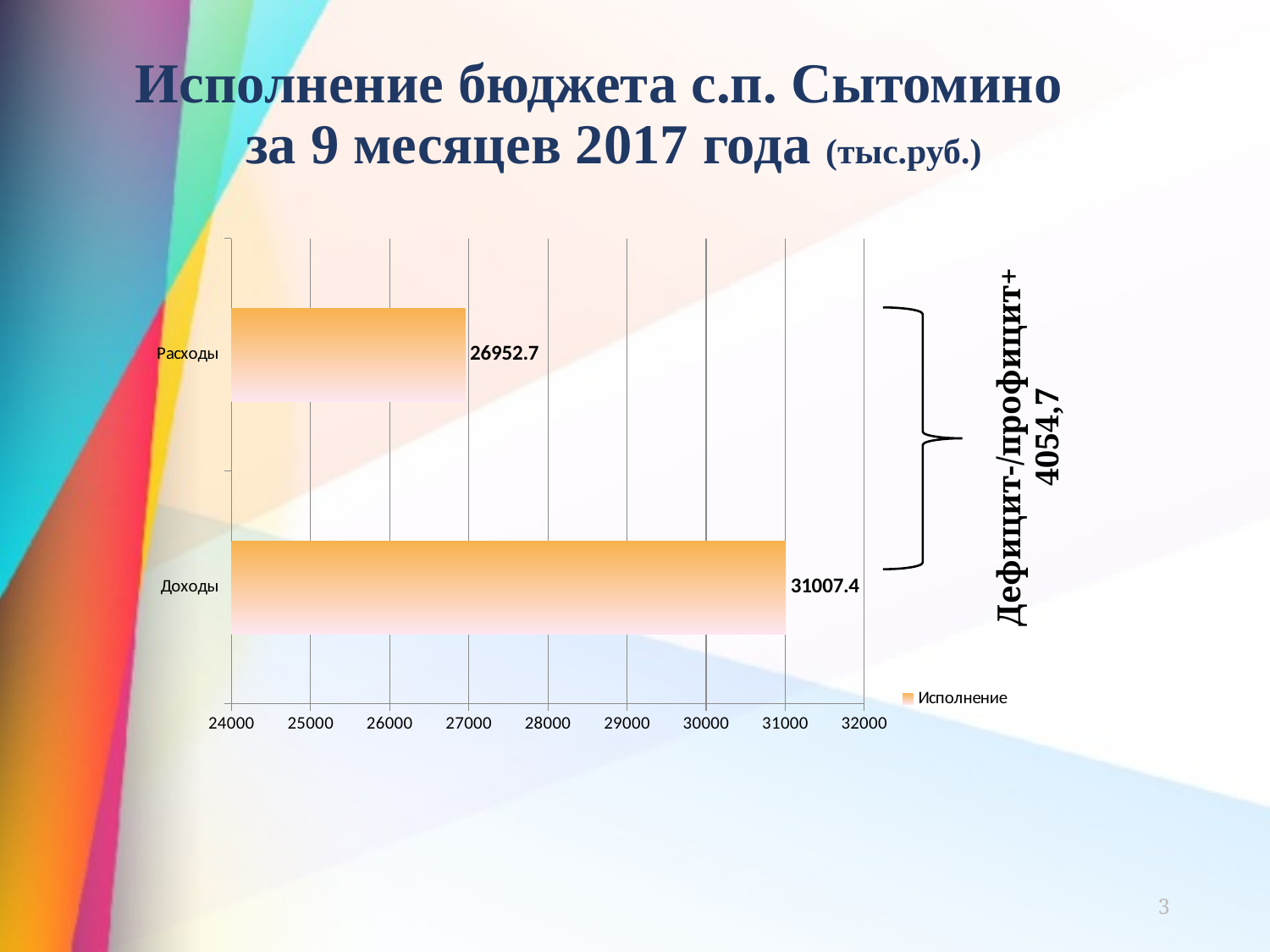
Which category has the highest value? Доходы What is the name of the series shown in the legend? Исполнение What is the value for Доходы? 31007.4 Which is larger, the value for Доходы or the value for Расходы? Доходы Is the value for Доходы greater or less than 30000? greater Which category has the lowest value? Расходы How many categories are shown in the chart? 2 What is the value for Расходы? 26952.7 Is the value for Расходы greater or less than 27000? less What is the difference between the values for Доходы and Расходы? 4054.7 What kind of chart is shown on the slide? bar chart How many series does the legend list? 1